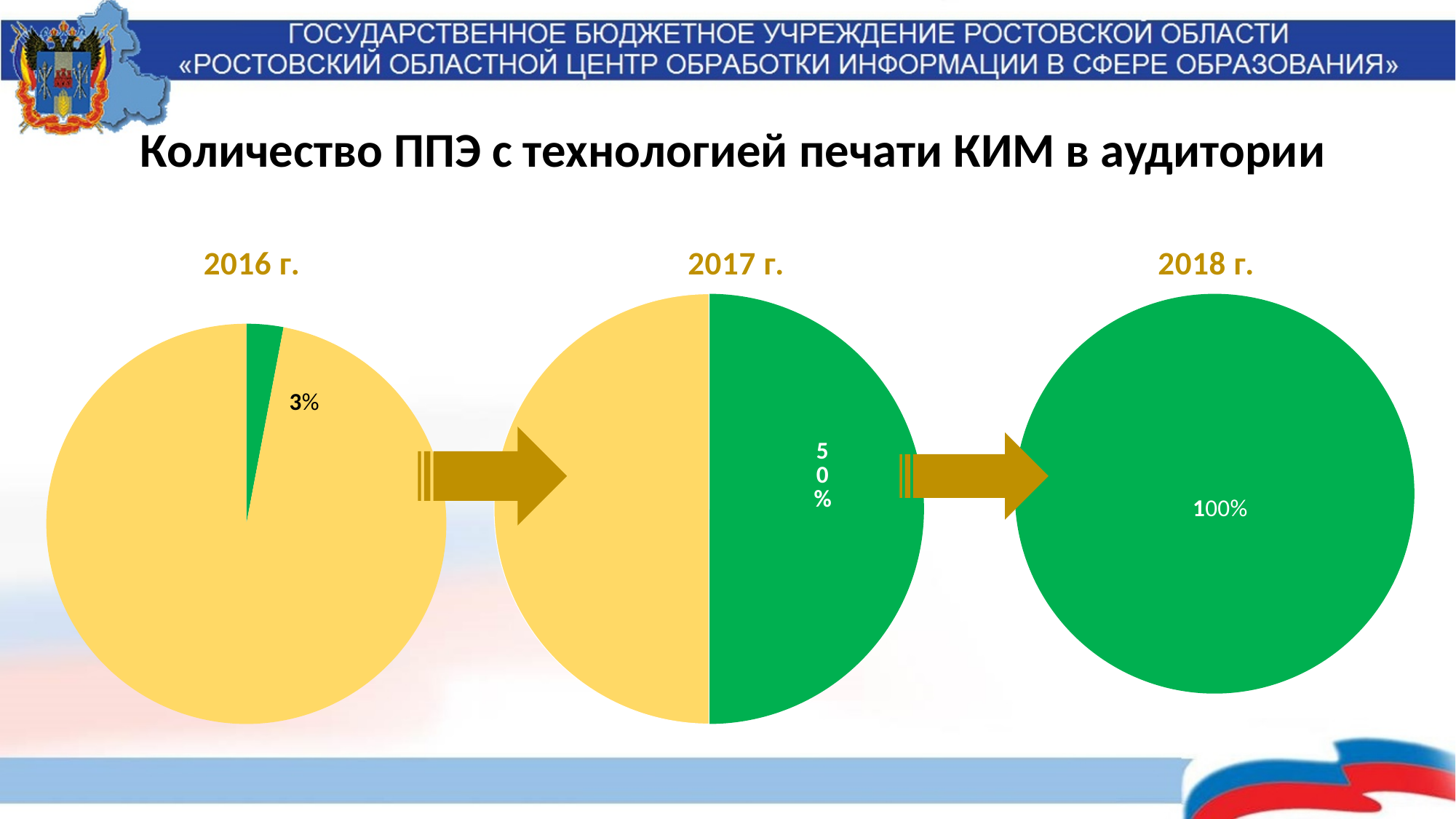
In the 2017 г. pie chart, what percentage does the green slice show? 50% Which is larger: the green share in the 2017 г. chart or the green share in the 2016 г. chart? 2017 г. Does the green share rise or fall from the 2016 г. chart to the 2018 г. chart? Rises What kind of charts are shown on the slide? Pie charts In the 2016 г. pie chart, what percentage does the green slice show? 3% What is the difference between the green share in the 2017 г. chart and the green share in the 2016 г. chart? 47% Which year's pie chart has the largest green share? 2018 г. How many pie charts are on the slide? 3 Which year's pie chart has the smallest green share? 2016 г. What is the difference between the green share in the 2018 г. chart and the green share in the 2017 г. chart? 50% What is the title of the slide above the pie charts? Количество ППЭ с технологией печати КИМ в аудитории In the 2018 г. pie chart, what percentage is labelled on the green area? 100%